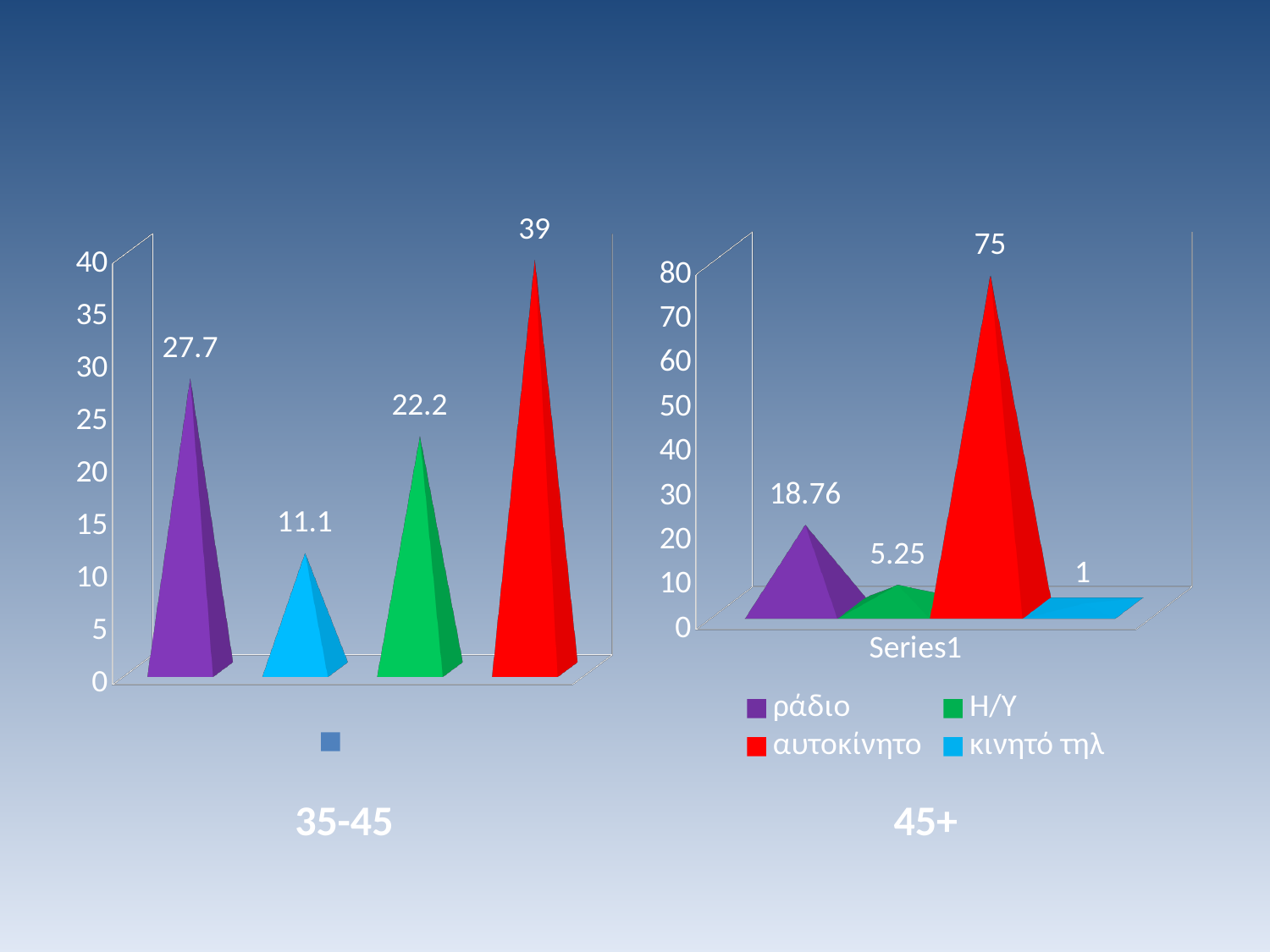
In the chart titled 45+, what is the value for αυτοκίνητο? 75 In the chart titled 45+, which series has the lowest value? κινητό τηλ In the chart titled 35-45, what is the difference between the red bar and the light blue bar? 27.9 In the chart titled 45+, what is the difference between the values for αυτοκίνητο and ράδιο? 56.24 In the chart titled 35-45, which is larger, the purple bar or the green bar? the purple bar In the chart titled 35-45, what is the value of the purple bar? 27.7 In the chart titled 45+, what is the value for κινητό τηλ? 1 In the chart titled 45+, how many series does the legend list? 4 In the chart titled 45+, what is the value for ράδιο? 18.76 What kind of chart is the chart titled 35-45? bar chart In the chart titled 35-45, what is the value of the red bar? 39 In the chart titled 45+, which series has the highest value? αυτοκίνητο